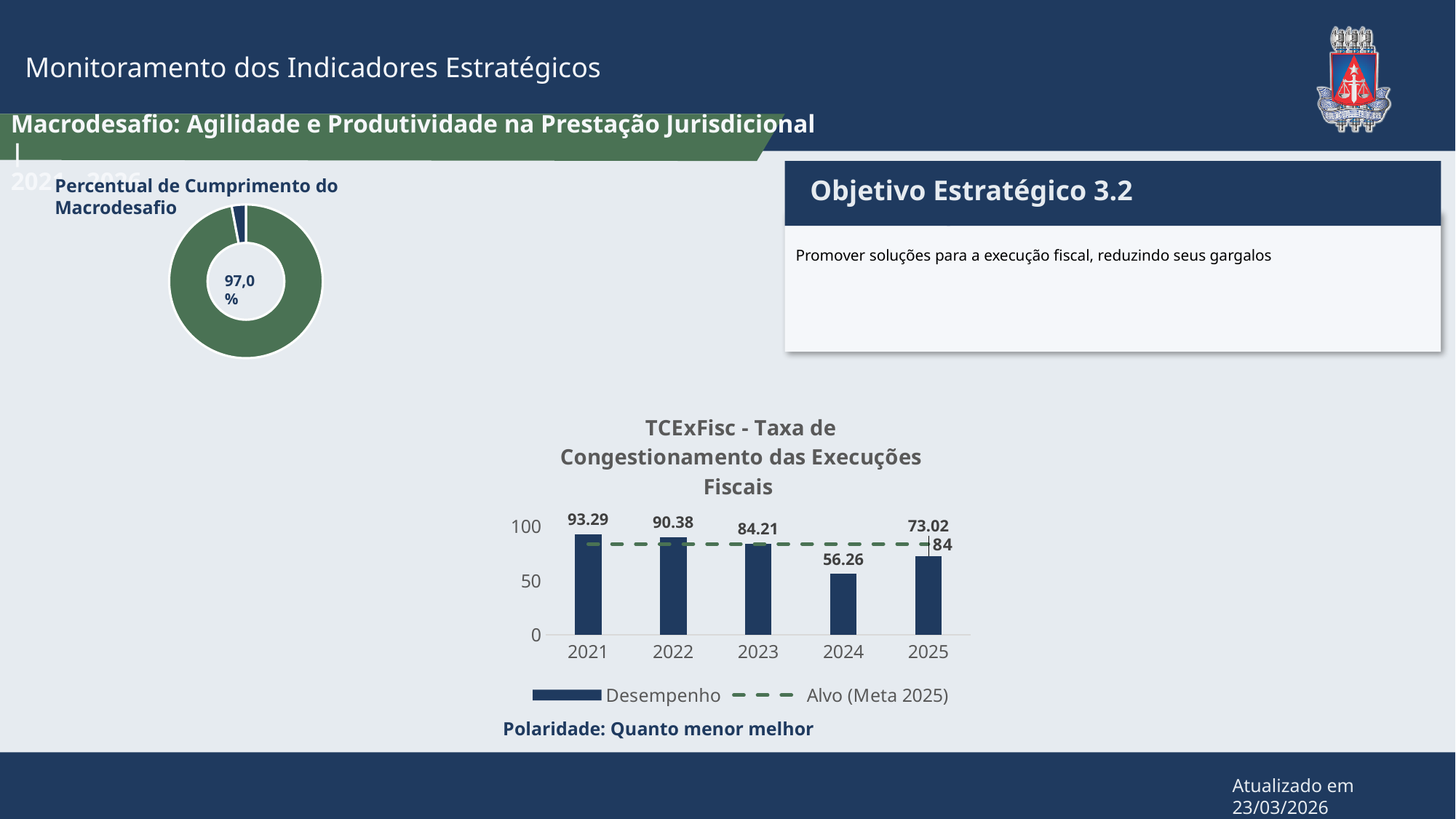
In the chart 'TCExFisc - Taxa de Congestionamento das Execuções Fiscais', how many years are shown on the x axis? 5 In the chart 'TCExFisc - Taxa de Congestionamento das Execuções Fiscais', what is the Desempenho value for 2024? 56.26 In the chart 'Percentual de Cumprimento do Macrodesafio', what percentage is shown in the centre of the donut? 97,0% In the chart 'TCExFisc - Taxa de Congestionamento das Execuções Fiscais', is the Desempenho value for 2023 larger or smaller than the value for 2025? larger In the chart 'TCExFisc - Taxa de Congestionamento das Execuções Fiscais', what is the difference between the Desempenho values for 2021 and 2025? 20.27 In the chart 'TCExFisc - Taxa de Congestionamento das Execuções Fiscais', what is the Desempenho value for 2021? 93.29 In the chart 'TCExFisc - Taxa de Congestionamento das Execuções Fiscais', which year has the highest Desempenho value? 2021 What kind of chart is 'Percentual de Cumprimento do Macrodesafio'? donut chart In the chart 'TCExFisc - Taxa de Congestionamento das Execuções Fiscais', how many series does the legend list? 2 In the chart 'TCExFisc - Taxa de Congestionamento das Execuções Fiscais', which year has the lowest Desempenho value? 2024 In the chart 'TCExFisc - Taxa de Congestionamento das Execuções Fiscais', what is the value of the Alvo (Meta 2025) line? 84 What kind of chart is 'TCExFisc - Taxa de Congestionamento das Execuções Fiscais'? combination bar and line chart (bars for Desempenho with a dashed target line)